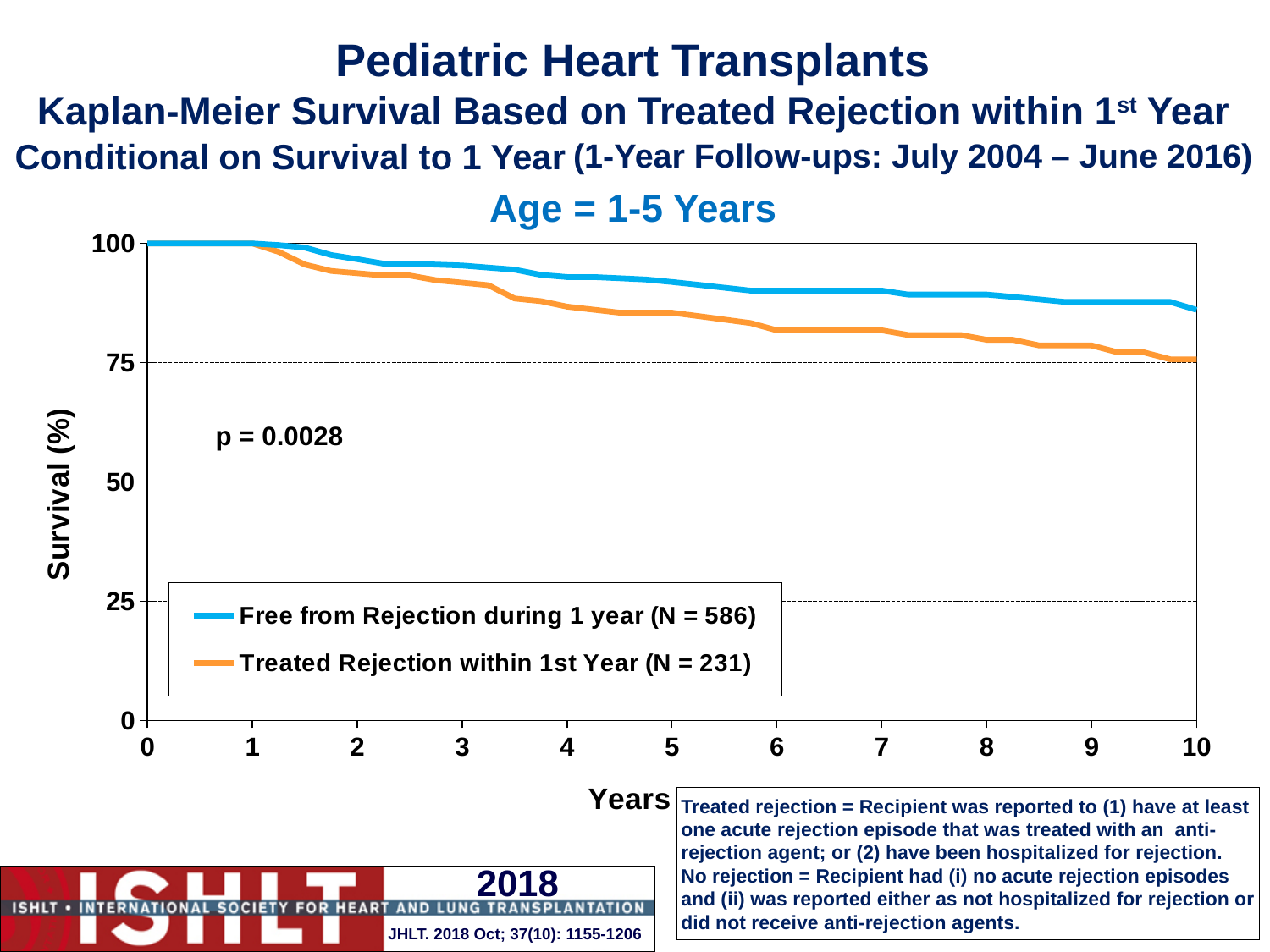
What p-value is shown on the chart? p = 0.0028 Do the survival curves rise or fall as years since transplant increase? Fall Is the survival for Treated Rejection within 1st Year at 8 years greater or less than 100? less What is the maximum value shown on the x axis (Years)? 10 How many series does the legend list? 2 Is the survival for Free from Rejection during 1 year at 3 years greater or less than 75? greater Which series has higher survival at 5 years: Free from Rejection during 1 year or Treated Rejection within 1st Year? Free from Rejection during 1 year Is the survival for Treated Rejection within 1st Year at 5 years greater or less than 75? greater What kind of chart is shown on the slide? Line chart What is the survival (%) for both series at 0 years? 100 What is the N for the Treated Rejection within 1st Year series? 231